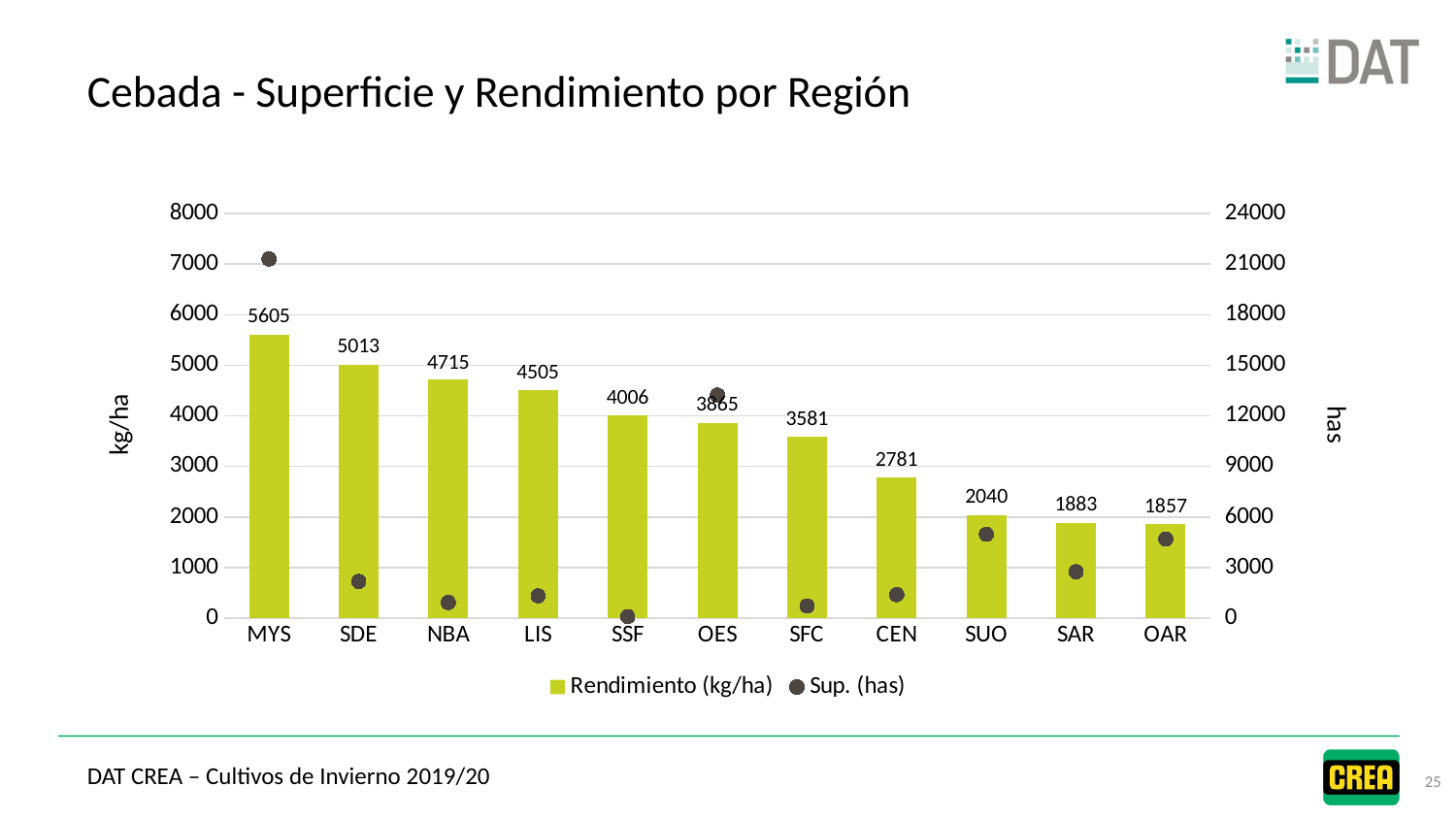
What is the Rendimiento (kg/ha) value for CEN? 2781 Which region has a higher Rendimiento (kg/ha), SUO or SAR? SUO Is the Sup. (has) value for SSF greater or less than 3000? less What is the difference in Rendimiento (kg/ha) between MYS and OAR? 3748 How many regions are shown on the x axis? 11 Which region has the lowest Rendimiento (kg/ha)? OAR Is the Sup. (has) value for MYS greater or less than 18000? greater How many series does the legend list? 2 Which region has the highest Rendimiento (kg/ha)? MYS What is the Rendimiento (kg/ha) value for SAR? 1883 What is the Rendimiento (kg/ha) value for MYS? 5605 Which region has the highest Sup. (has)? MYS